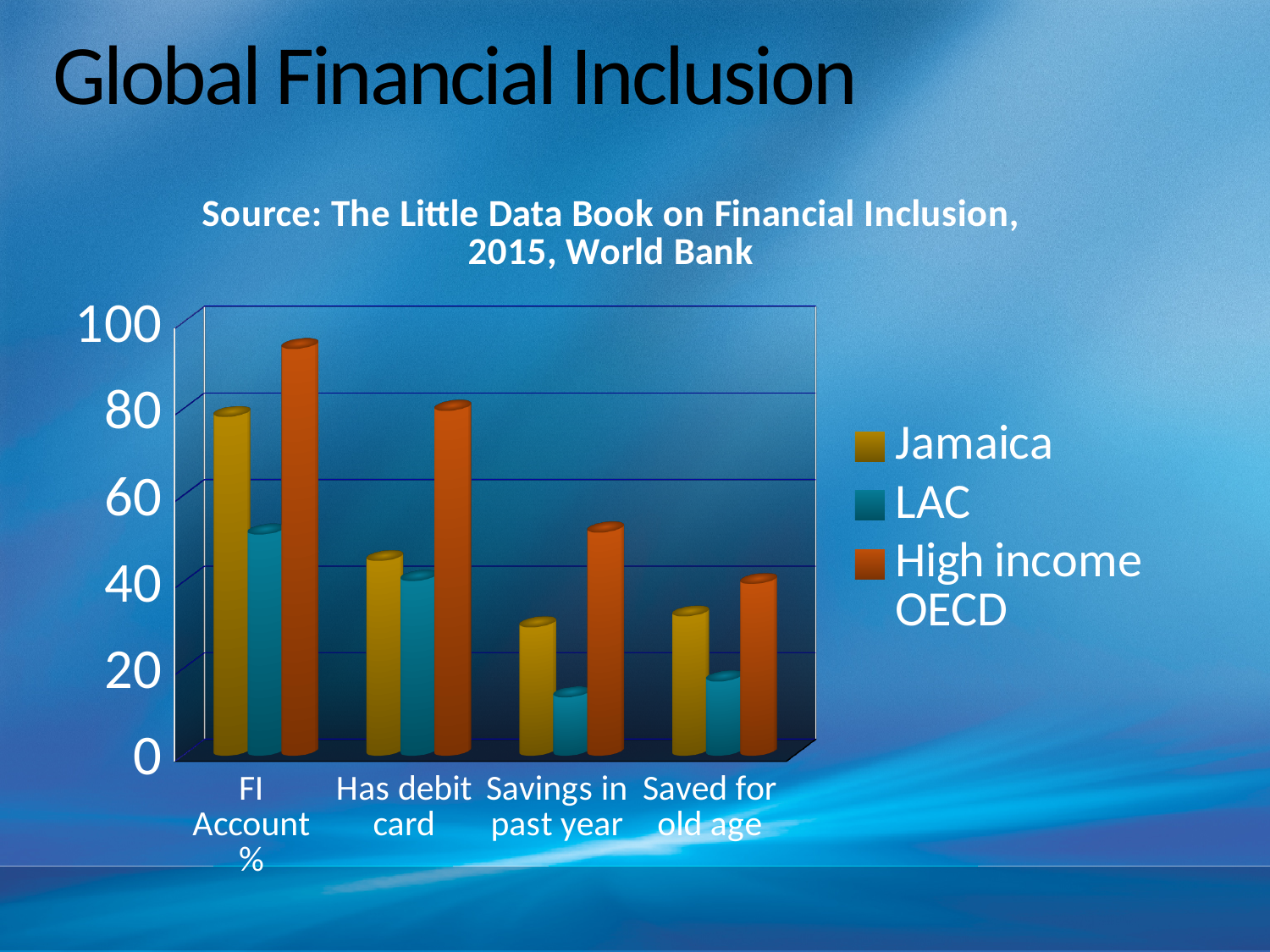
Is the value for High income OECD in FI Account % greater or less than 80? greater How many categories are shown on the x axis? 4 What source is cited above the chart? The Little Data Book on Financial Inclusion, 2015, World Bank Which series has the highest value for FI Account %? High income OECD Which is larger: Jamaica's value for Has debit card or Jamaica's value for Savings in past year? Has debit card Which series has the lowest value for Savings in past year? LAC Is the value for High income OECD in Has debit card greater or less than 60? greater Is the value for Jamaica in FI Account % greater or less than 60? greater How many series does the legend list? 3 What kind of chart is shown on the slide? bar chart Do the Jamaica values rise or fall from FI Account % to Savings in past year? fall